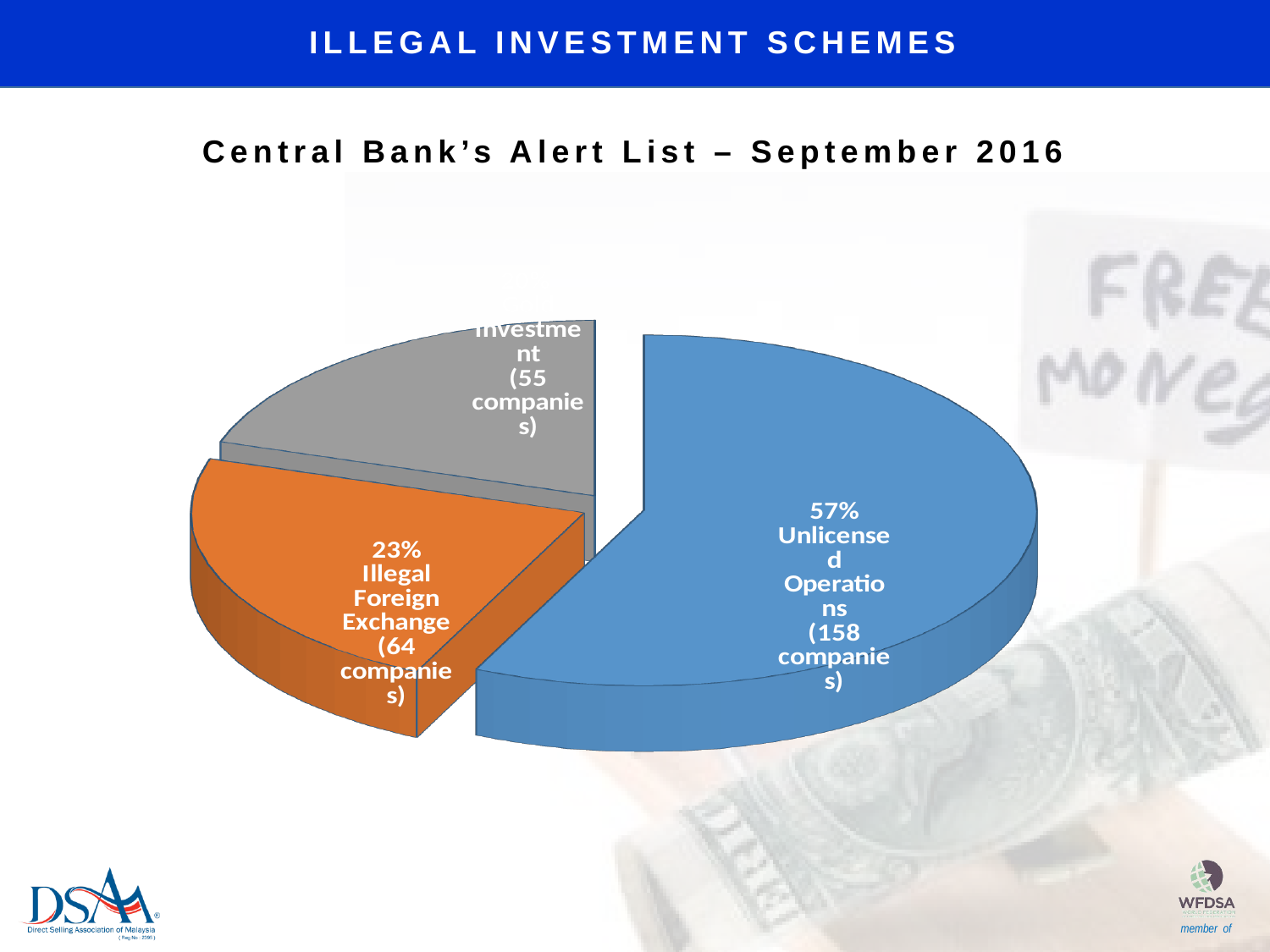
What percentage of the pie does Unlicensed Operations account for? 57% Which is larger, the share for Unlicensed Operations or the share for Illegal Foreign Exchange? Unlicensed Operations What is the title shown above the pie chart? Central Bank's Alert List – September 2016 How many companies are listed in the grey slice of the pie? 55 companies How many companies are listed under Illegal Foreign Exchange? 64 companies How many companies are listed under Unlicensed Operations? 158 companies What percentage of the pie does Illegal Foreign Exchange account for? 23% How many more companies are under Unlicensed Operations than under Illegal Foreign Exchange? 94 companies How many slices does the pie chart have? 3 Which category has the largest slice of the pie? Unlicensed Operations By how many percentage points does the Unlicensed Operations share exceed the Illegal Foreign Exchange share? 34 percentage points What type of chart is shown on the slide? Pie chart